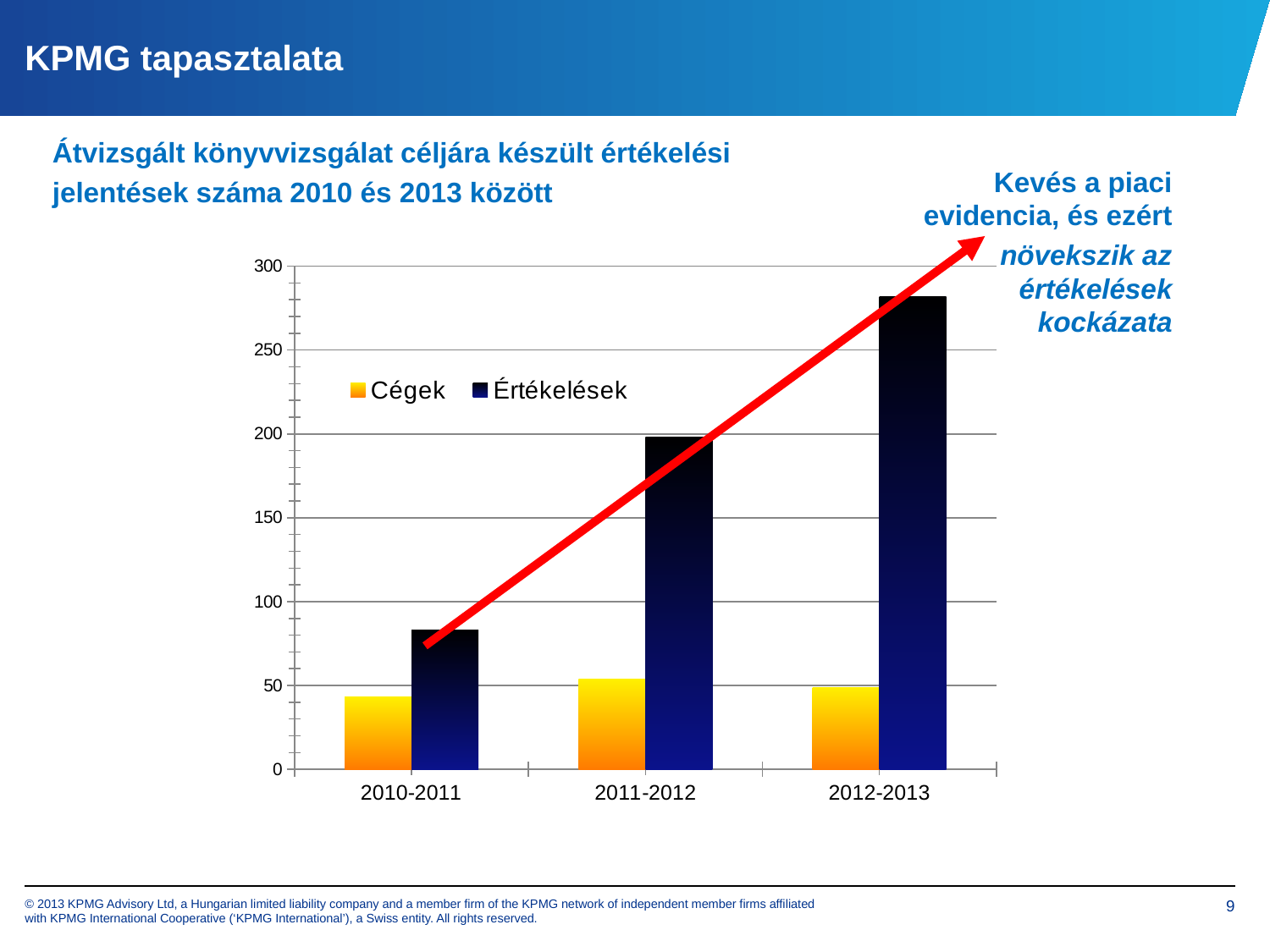
What kind of chart is shown on the slide? bar chart Is the value for Értékelések in 2010-2011 greater or less than 100? less How many series does the chart's legend list? 2 How many categories are shown on the x axis of the chart? 3 What are the two series named in the chart's legend? Cégek and Értékelések Which category has the lowest value for Értékelések? 2010-2011 Is the value for Értékelések in 2011-2012 greater or less than 150? greater Which category has the highest value for Értékelések? 2012-2013 Is the value for Értékelések in 2012-2013 greater or less than 250? greater In 2011-2012, which series has the larger value, Cégek or Értékelések? Értékelések Do the values for Értékelések rise or fall from 2010-2011 to 2012-2013? rise